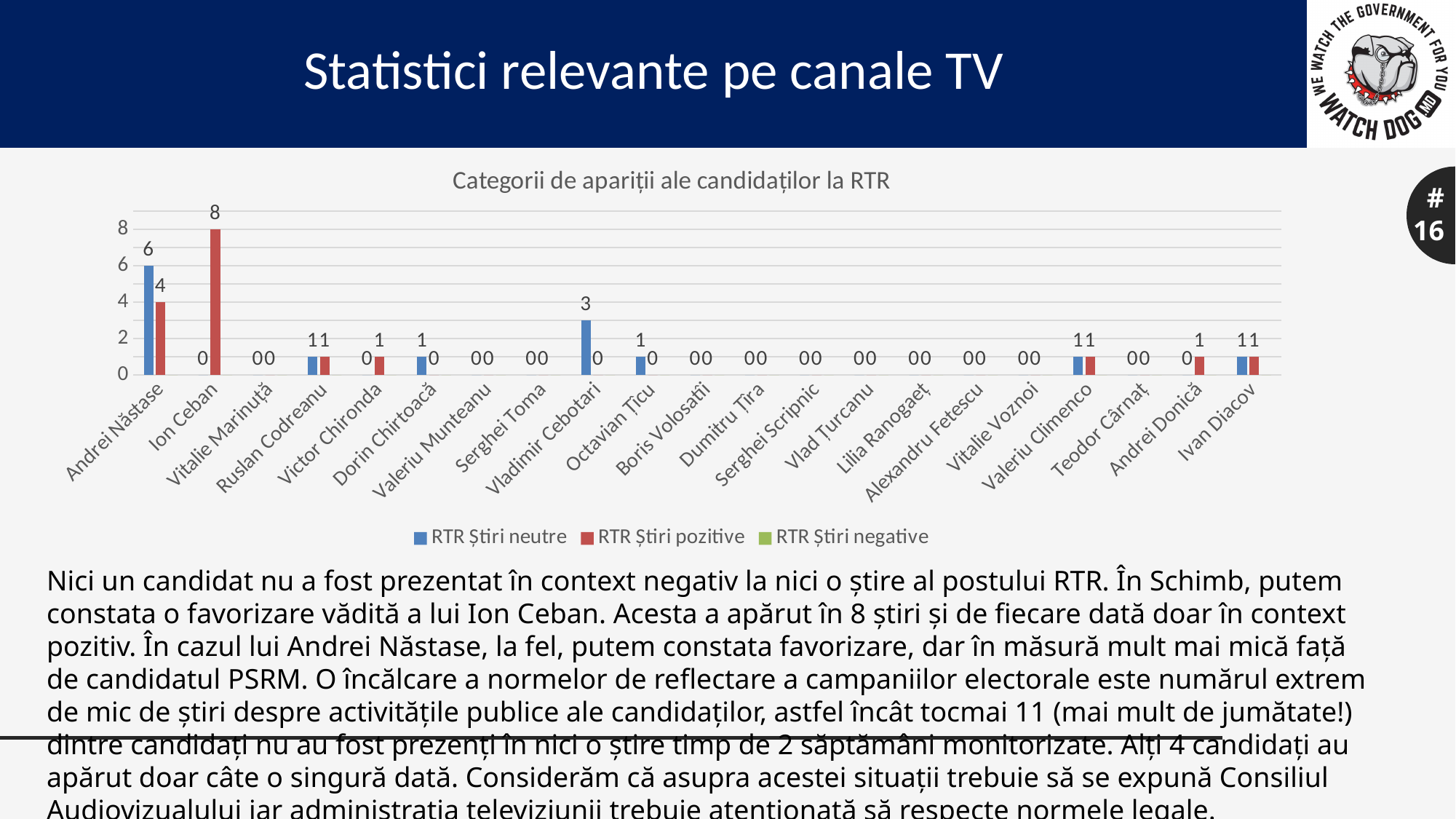
What type of chart is shown on the slide? bar chart How many series does the legend list? 3 What is the value of RTR Știri pozitive for Ion Ceban? 8 What is the value of RTR Știri neutre for Andrei Năstase? 6 Which candidate has the highest value for RTR Știri neutre? Andrei Năstase Which is larger: RTR Știri pozitive for Ion Ceban or RTR Știri neutre for Andrei Năstase? RTR Știri pozitive for Ion Ceban Which candidate has the highest value for RTR Știri pozitive? Ion Ceban What is the difference between RTR Știri neutre and RTR Știri pozitive for Andrei Năstase? 2 What is the value of RTR Știri neutre for Vladimir Cebotari? 3 What is the title of the chart? Categorii de apariții ale candidaților la RTR What is the value of RTR Știri pozitive for Andrei Donică? 1 How many candidates are shown on the x axis? 21